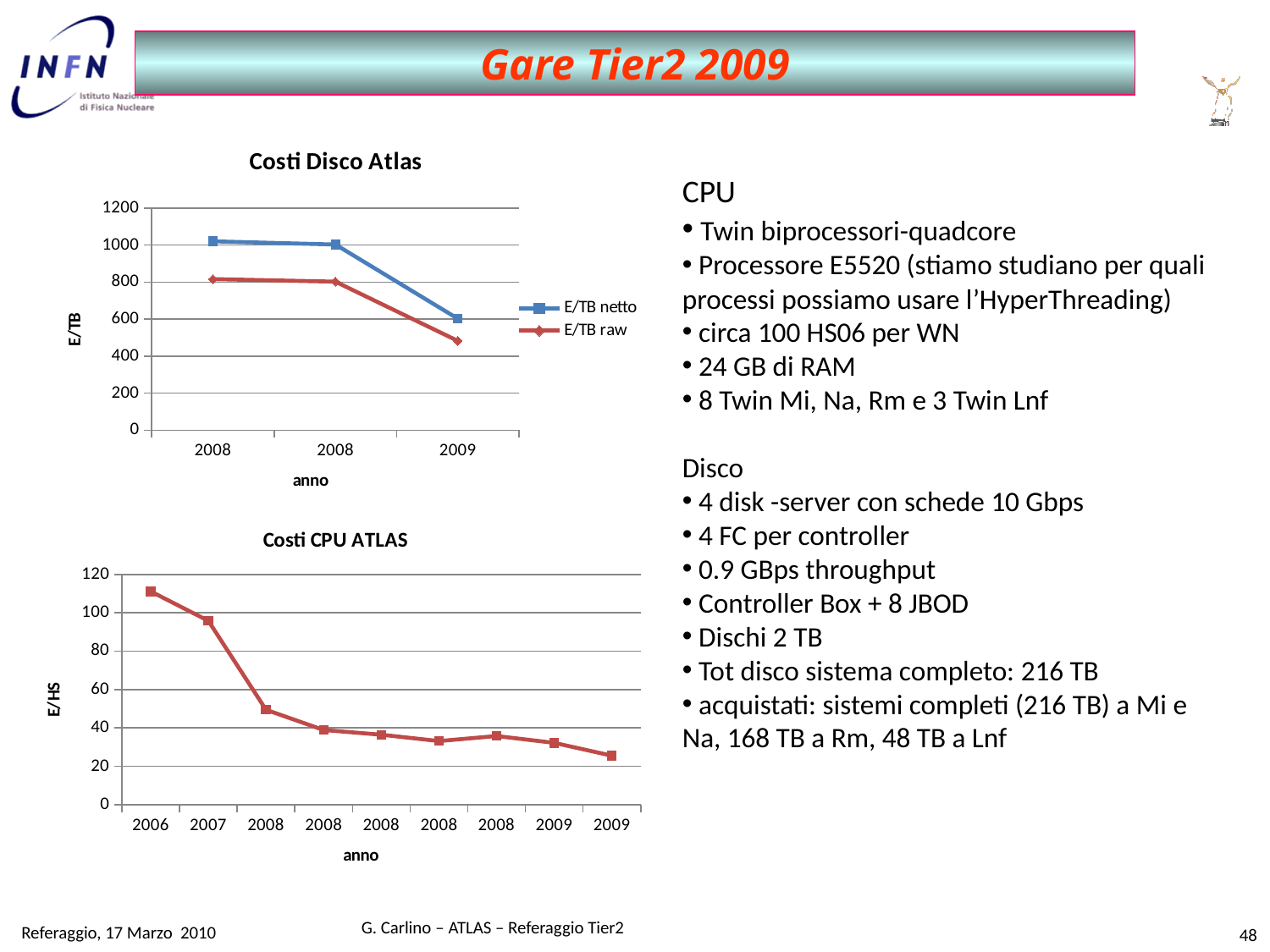
What kind of chart is the 'Costi Disco Atlas' chart? line chart In the 'Costi Disco Atlas' chart, which series has the larger value at 2009, E/TB netto or E/TB raw? E/TB netto What kind of chart is the 'Costi CPU ATLAS' chart? line chart In the 'Costi CPU ATLAS' chart, is the value for 2006 greater or less than 100? greater In the 'Costi Disco Atlas' chart, do the values rise or fall from the first point to 2009? fall What is the y-axis label of the 'Costi Disco Atlas' chart? E/TB In the 'Costi Disco Atlas' chart, is the E/TB netto value for 2009 greater or less than 800? less How many data points are plotted in the 'Costi CPU ATLAS' chart? 9 In the 'Costi CPU ATLAS' chart, do the values generally rise or fall from 2006 to 2009? fall In the 'Costi Disco Atlas' chart, is the E/TB raw value for 2009 greater or less than 600? less In the 'Costi CPU ATLAS' chart, which year has the highest value? 2006 How many series does the legend of the 'Costi Disco Atlas' chart list? 2